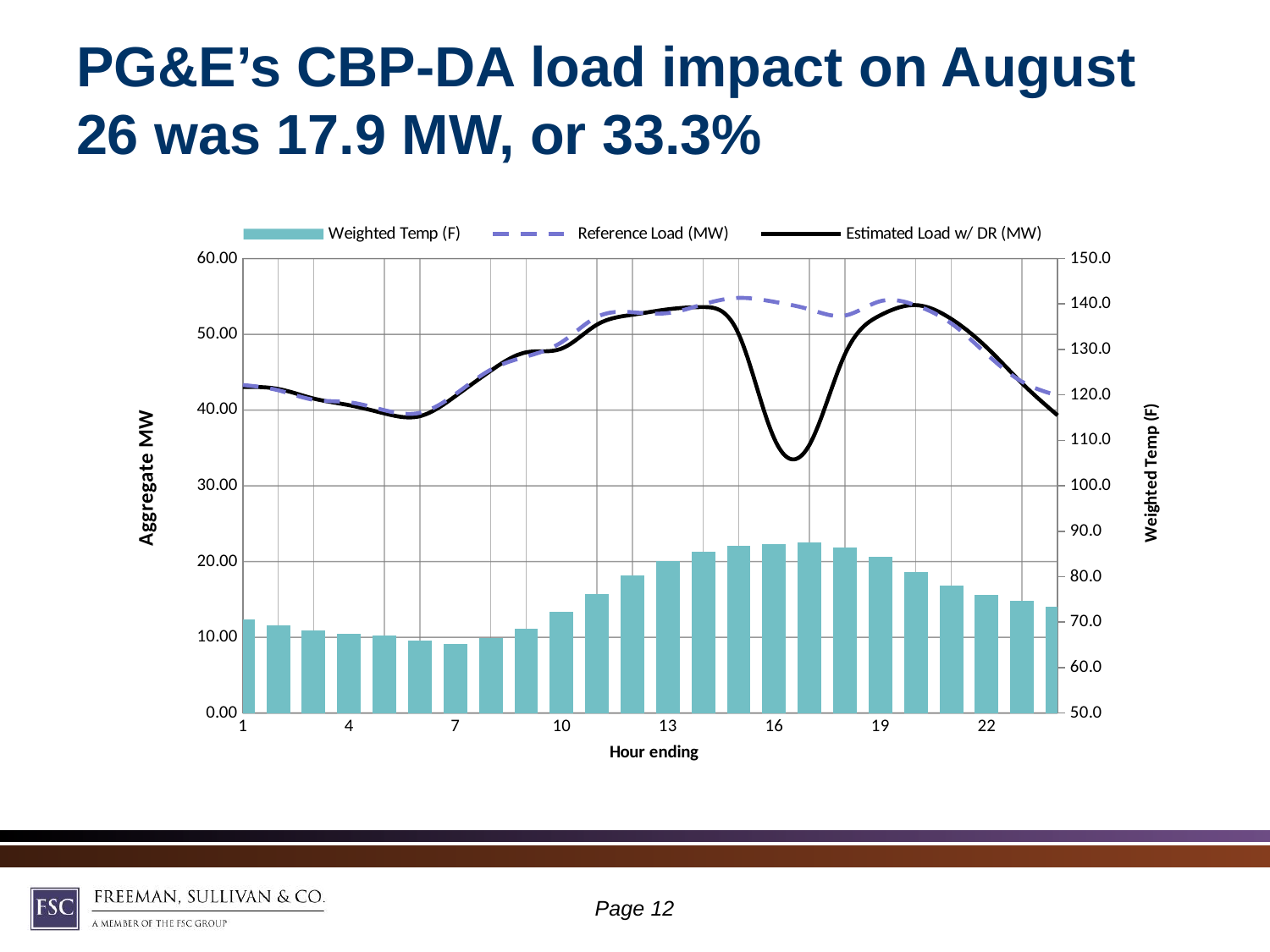
What is the title of the left vertical axis? Aggregate MW Which is larger: the Weighted Temp (F) at hour ending 13 or at hour ending 3? Hour ending 13 Is the Reference Load (MW) at hour ending 15 greater or less than 50.00 on the left axis? greater Is the Weighted Temp (F) at hour ending 7 greater or less than 70.0 on the right axis? less At hour ending 17, which is larger: the Reference Load (MW) or the Estimated Load w/ DR (MW)? Reference Load (MW) What kind of chart is shown on the slide? Combination bar and line chart Is the Weighted Temp (F) at hour ending 17 greater or less than 80.0 on the right axis? greater Does the Estimated Load w/ DR (MW) rise or fall between hour ending 14 and hour ending 17? Fall How many hours (bars) are plotted along the x axis? 24 How many series does the chart legend list? 3 Which series is drawn as a dashed line? Reference Load (MW)